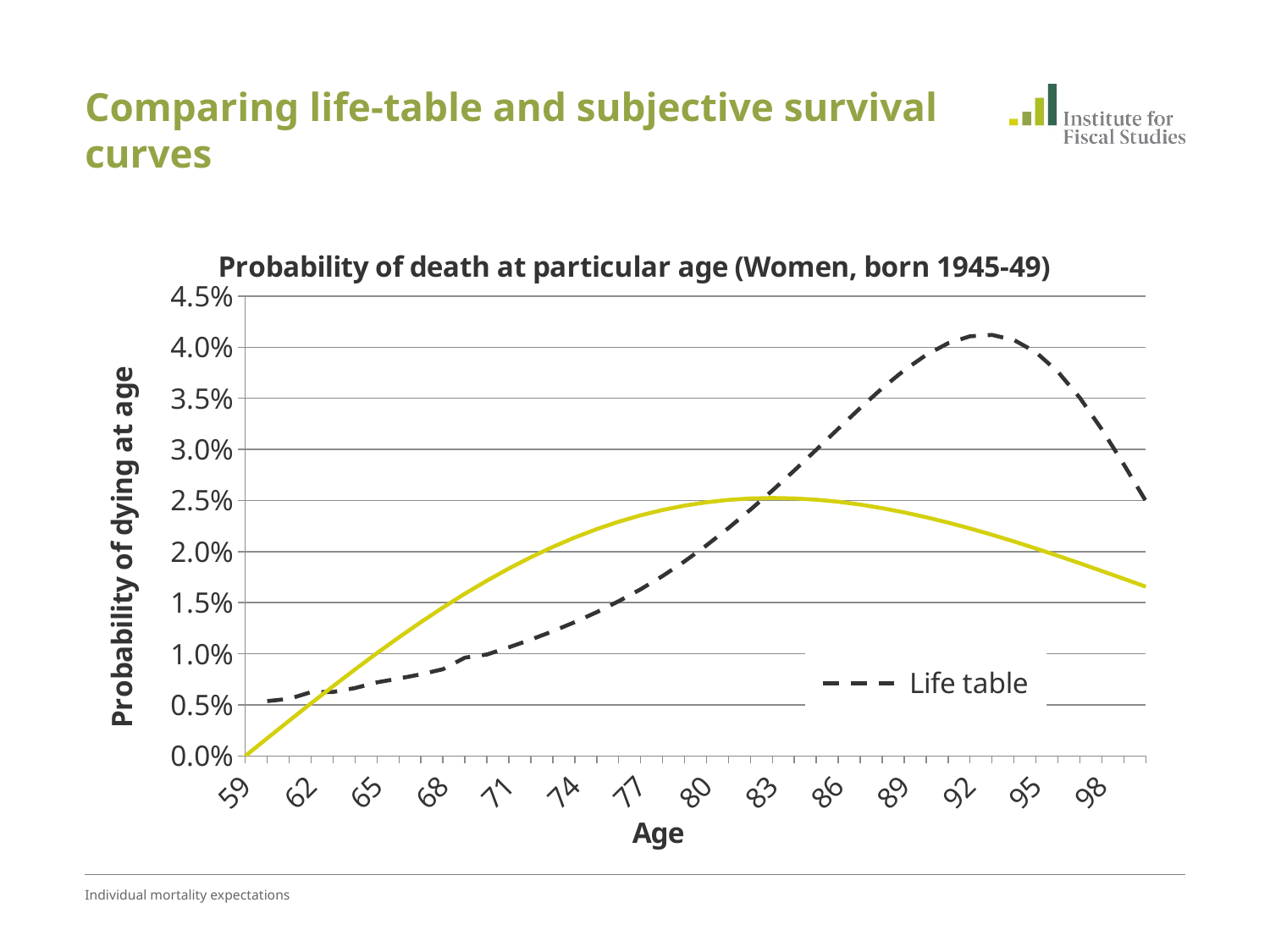
What is the title of the chart? Probability of death at particular age (Women, born 1945-49) What is the value of the solid yellow line at age 59? 0.0% Does the Life table line rise or fall between age 59 and age 89? rise At age 68, which is higher: the Life table line or the solid yellow line? the solid yellow line What is the label of the vertical axis? Probability of dying at age Is the Life table value at age 89 greater or less than 3.0%? greater At age 92, which is higher: the Life table line or the solid yellow line? Life table What kind of chart is shown on the slide? line chart Is the Life table value at age 65 greater or less than 1.0%? less Is the value of the solid yellow line at age 71 greater or less than 1.5%? greater How many age labels are shown on the x axis? 14